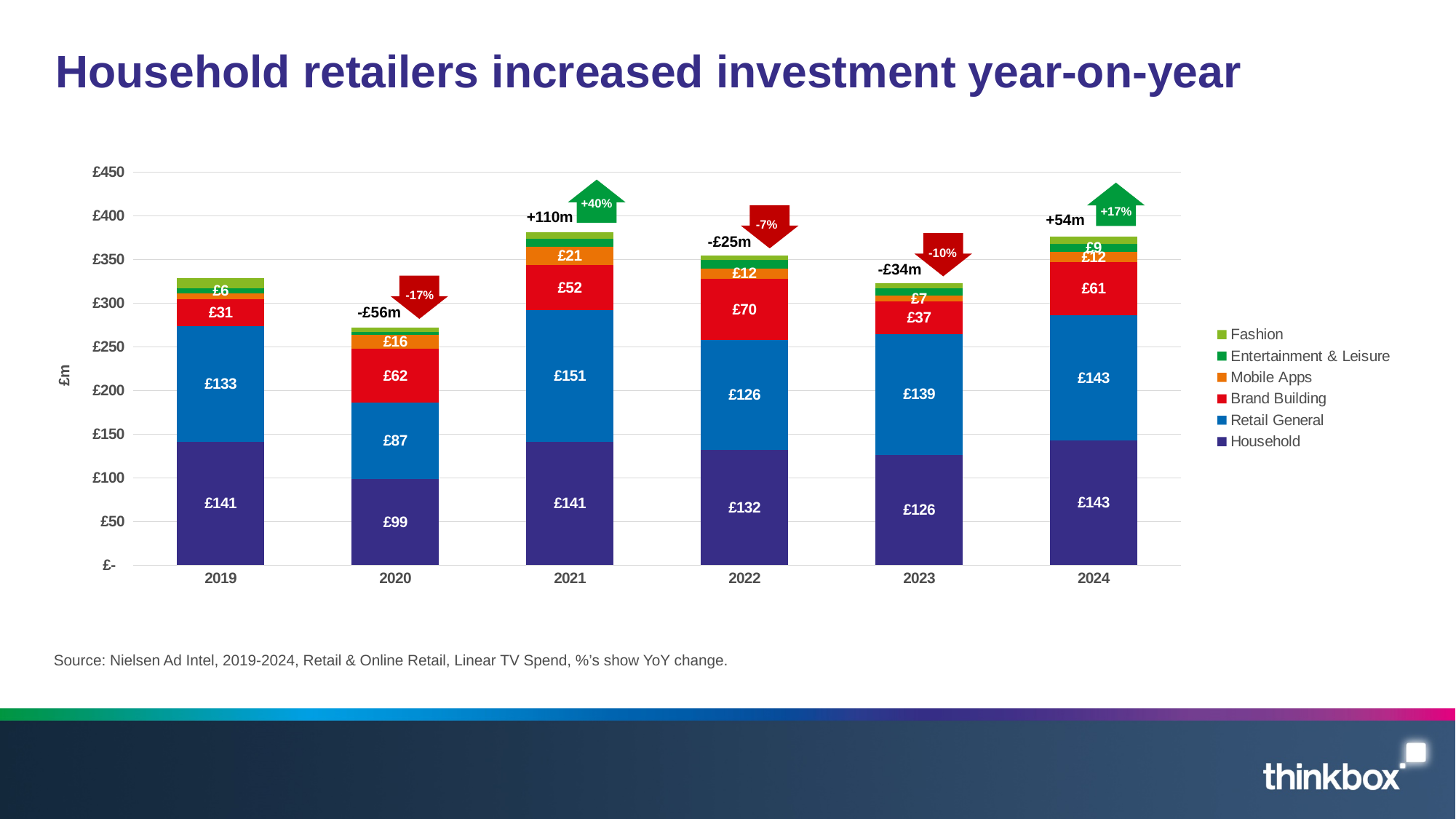
What is the Brand Building value for 2022? £70 What is the Mobile Apps value for 2023? £7 Is the total height of the 2020 bar greater or less than £300? less How many series does the legend list? 6 What is the difference between the Brand Building values for 2022 and 2023? £33 How many years are shown on the x axis? 6 In which year is the Brand Building value the lowest? 2019 What kind of chart is shown on the slide? Stacked bar chart In 2023, which is larger: Retail General or Household? Retail General In which year is the Household value the highest? 2024 What is the Retail General value for 2021? £151 What is the Household value for 2020? £99